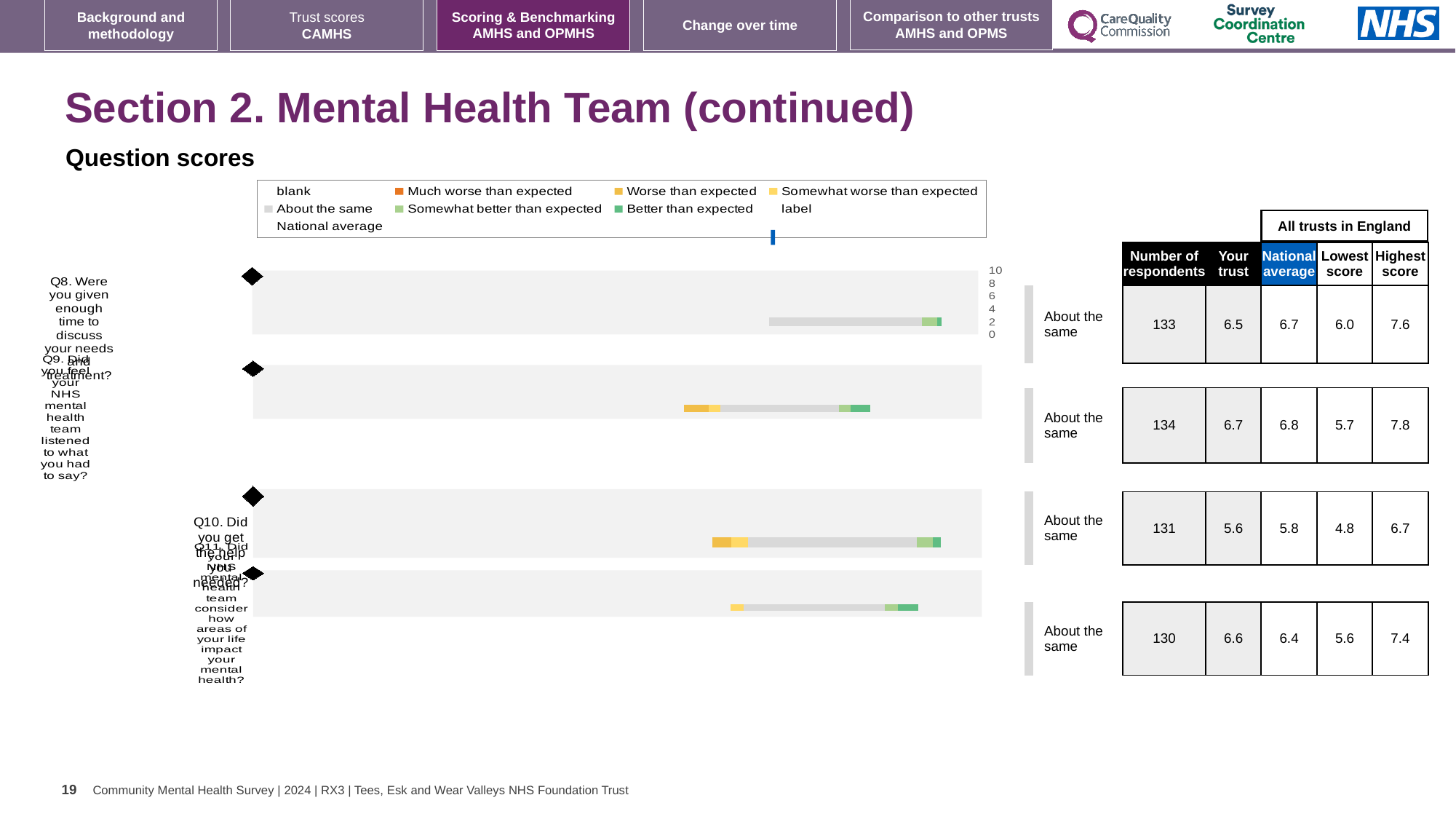
In the table next to the chart, what is the 'Your trust' score for Q10? 5.6 What is the difference between the highest score and the lowest score for Q8 in the table? 1.6 What kind of chart is used to show the question scores on this slide? bar chart In the table next to the chart, how many respondents answered Q8? 133 Which question has the highest number of respondents in the table? Q9 What benchmark category is shown for each of the four questions beside the chart? About the same What is the difference between the national average and the 'Your trust' score for Q10? 0.2 What is the heading above the National average, Lowest score and Highest score columns in the table? All trusts in England Which question has the lowest 'Your trust' score in the table? Q10 For Q11, which is larger in the table: the 'Your trust' score or the national average? Your trust How many questions (categories) are plotted in the question scores chart? 4 In the table next to the chart, what is the national average for Q9? 6.8